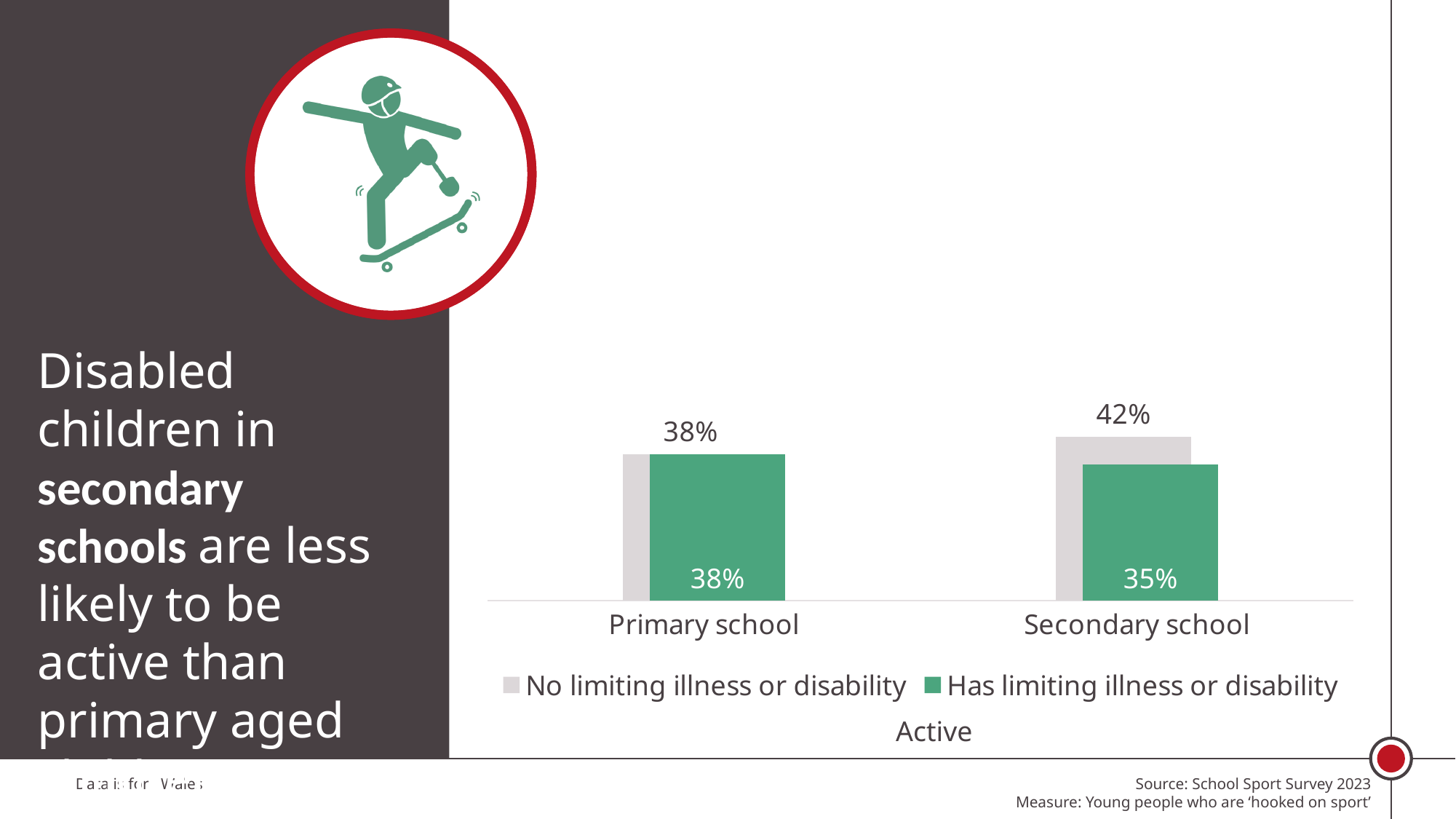
What colour are the bars for 'Has limiting illness or disability'? green What is the value for 'No limiting illness or disability' in Secondary school? 42% How many categories are shown on the x axis of the chart? 2 Which category has the highest value for 'No limiting illness or disability'? Secondary school What is the value for 'Has limiting illness or disability' in Secondary school? 35% How many series does the chart legend list? 2 What is the value for 'Has limiting illness or disability' in Primary school? 38% What is the difference between the 'No limiting illness or disability' and 'Has limiting illness or disability' values for Secondary school? 7% In Secondary school, which series has the larger value: 'No limiting illness or disability' or 'Has limiting illness or disability'? No limiting illness or disability What is the value for 'No limiting illness or disability' in Primary school? 38% What type of chart is shown on the slide? bar chart Which category has the lowest value for 'Has limiting illness or disability'? Secondary school